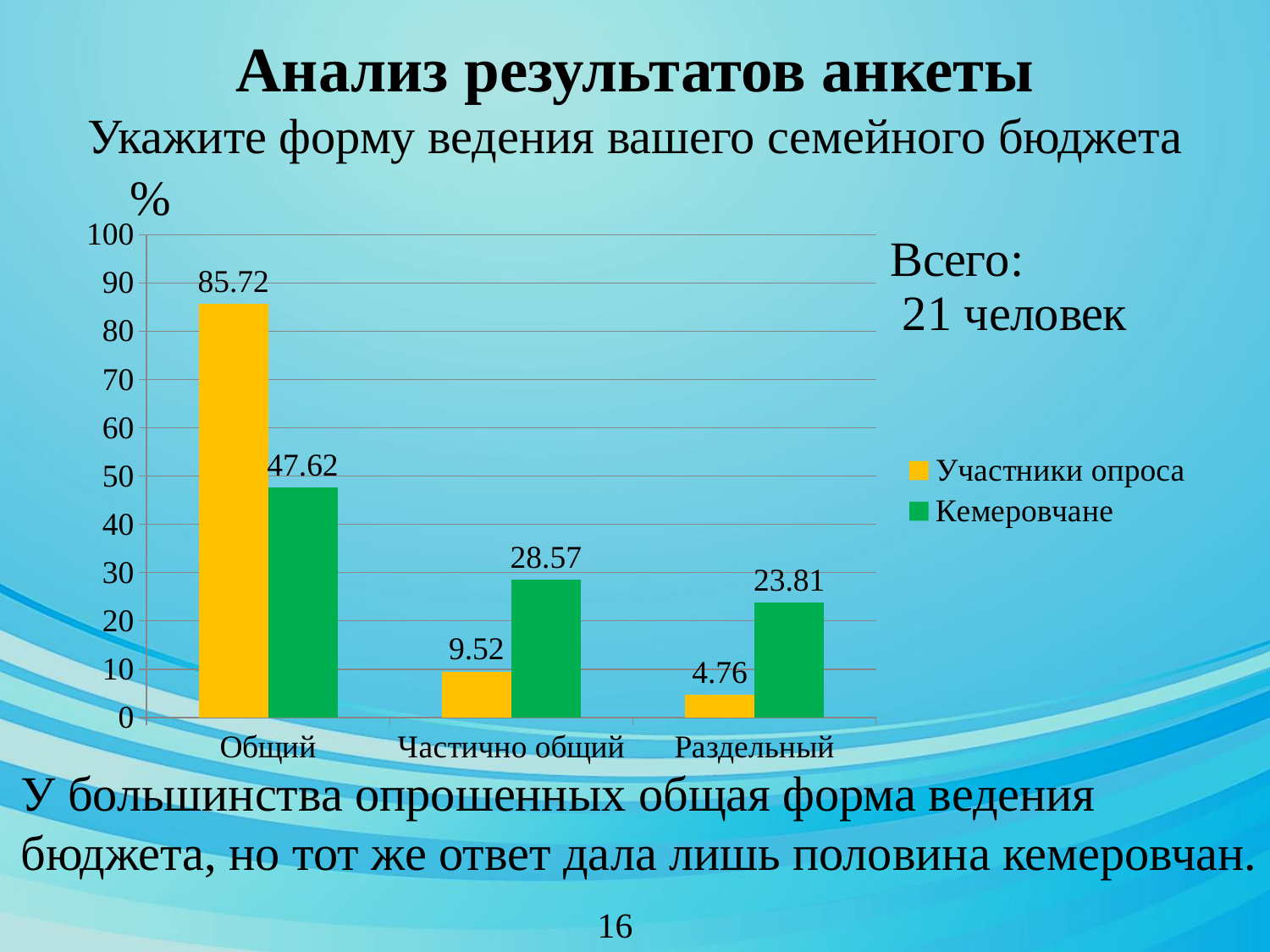
How many series does the legend list? 2 How many categories are shown on the x axis? 3 Which category has the highest value for Кемеровчане? Общий What is the value for Участники опроса in the Раздельный category? 4.76 Which is larger in the Раздельный category: Участники опроса or Кемеровчане? Кемеровчане What kind of chart is shown on the slide? bar chart Which category has the lowest value for Участники опроса? Раздельный What is the value for Кемеровчане in the Частично общий category? 28.57 What is the difference between Участники опроса and Кемеровчане in the Общий category? 38.1 Is the value for Кемеровчане in the Общий category greater or less than 50? less What is the value for Участники опроса in the Общий category? 85.72 Which colour represents Кемеровчане in the chart? green